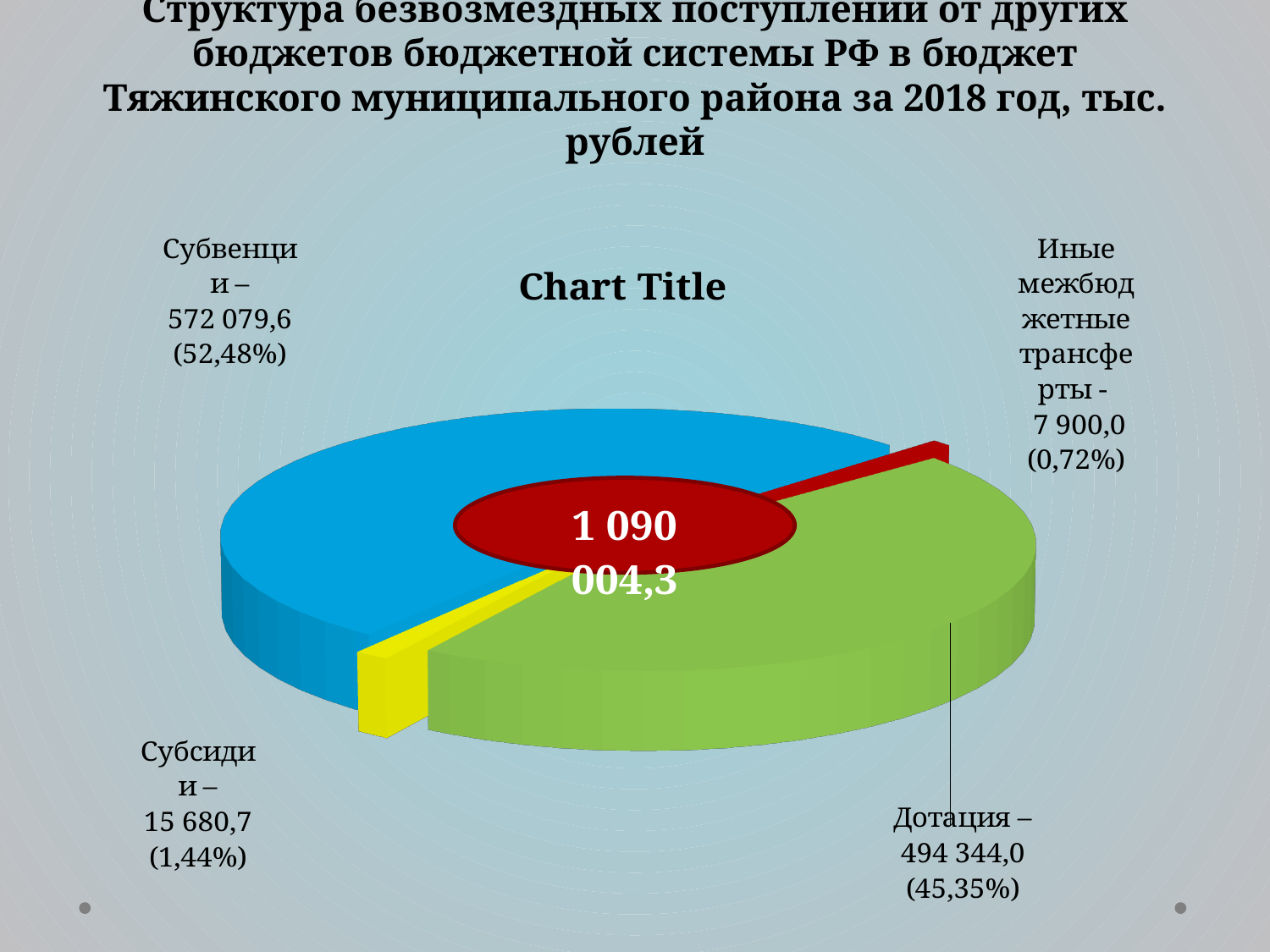
What share of the pie do Иные межбюджетные трансферты make up? 0,72% Which category has the smallest slice? Иные межбюджетные трансферты What is the value for Субсидии? 15 680,7 Which category has the largest slice? Субвенции What is the value for Дотация? 494 344,0 How many slices does the pie chart have? 4 What is the value for Субвенции? 572 079,6 What total value is printed in the centre of the pie chart? 1 090 004,3 What type of chart is shown on the slide? pie chart What share of the pie does Дотация make up? 45,35% Which is larger, Субсидии or Иные межбюджетные трансферты? Субсидии What share of the pie do Субвенции make up? 52,48%